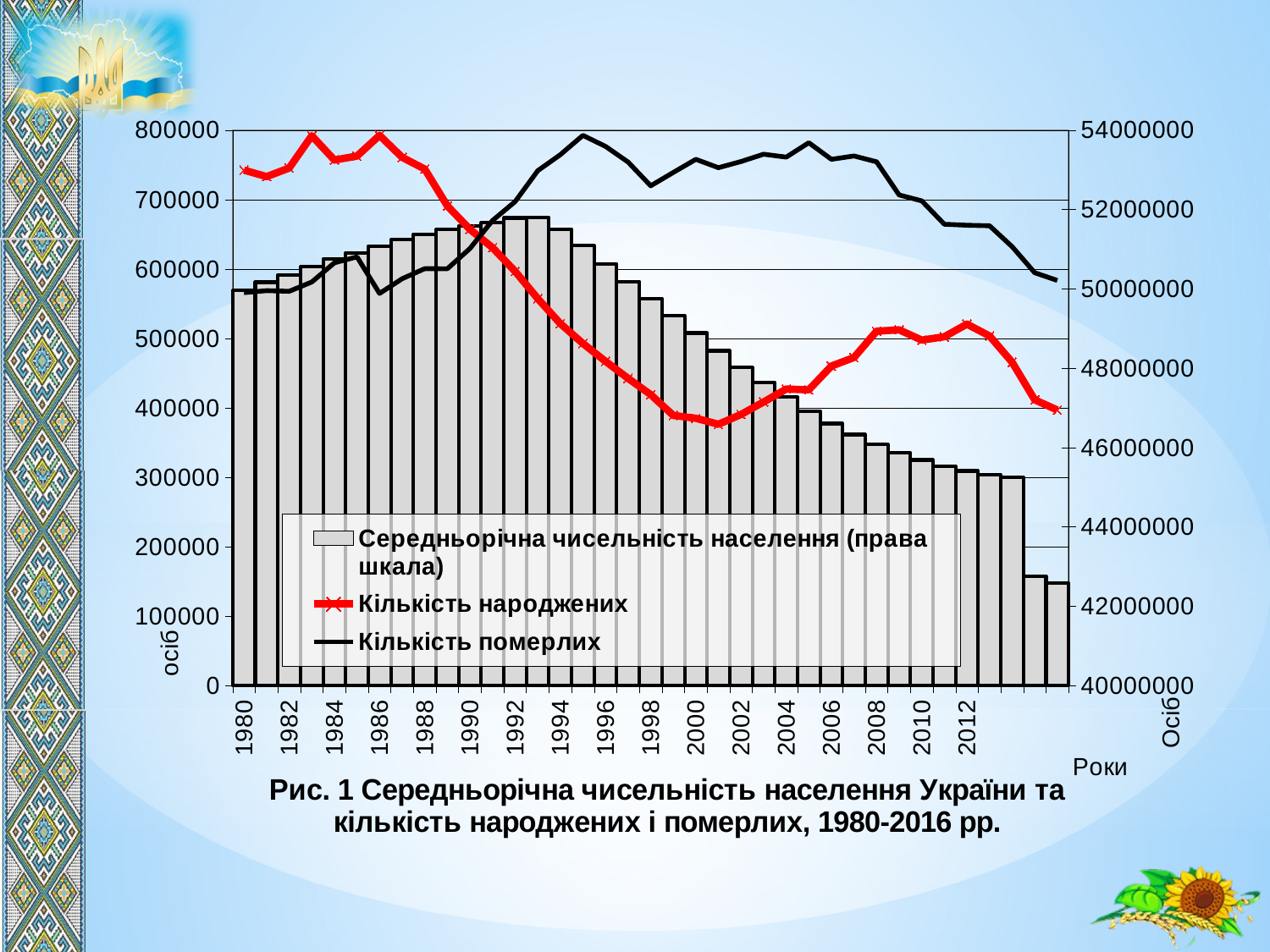
Do the values of Кількість народжених rise or fall from 1986 to 2001? Fall In which year is the value of Кількість померлих highest? 1995 What kind of chart is shown on the slide? A combined bar and line chart How many series does the legend list? 3 In which year is the value of Кількість народжених lowest? 2001 Which series is plotted against the right-hand axis? Середньорічна чисельність населення What colour is the line for Кількість народжених? Red Is the bar for Середньорічна чисельність населення in 2016 greater or less than 44000000? less Is the bar for Середньорічна чисельність населення in 1992 greater or less than 50000000? greater In 2000, which is larger: Кількість народжених or Кількість померлих? Кількість померлих Is the value of Кількість народжених in 2001 greater or less than 400000? less